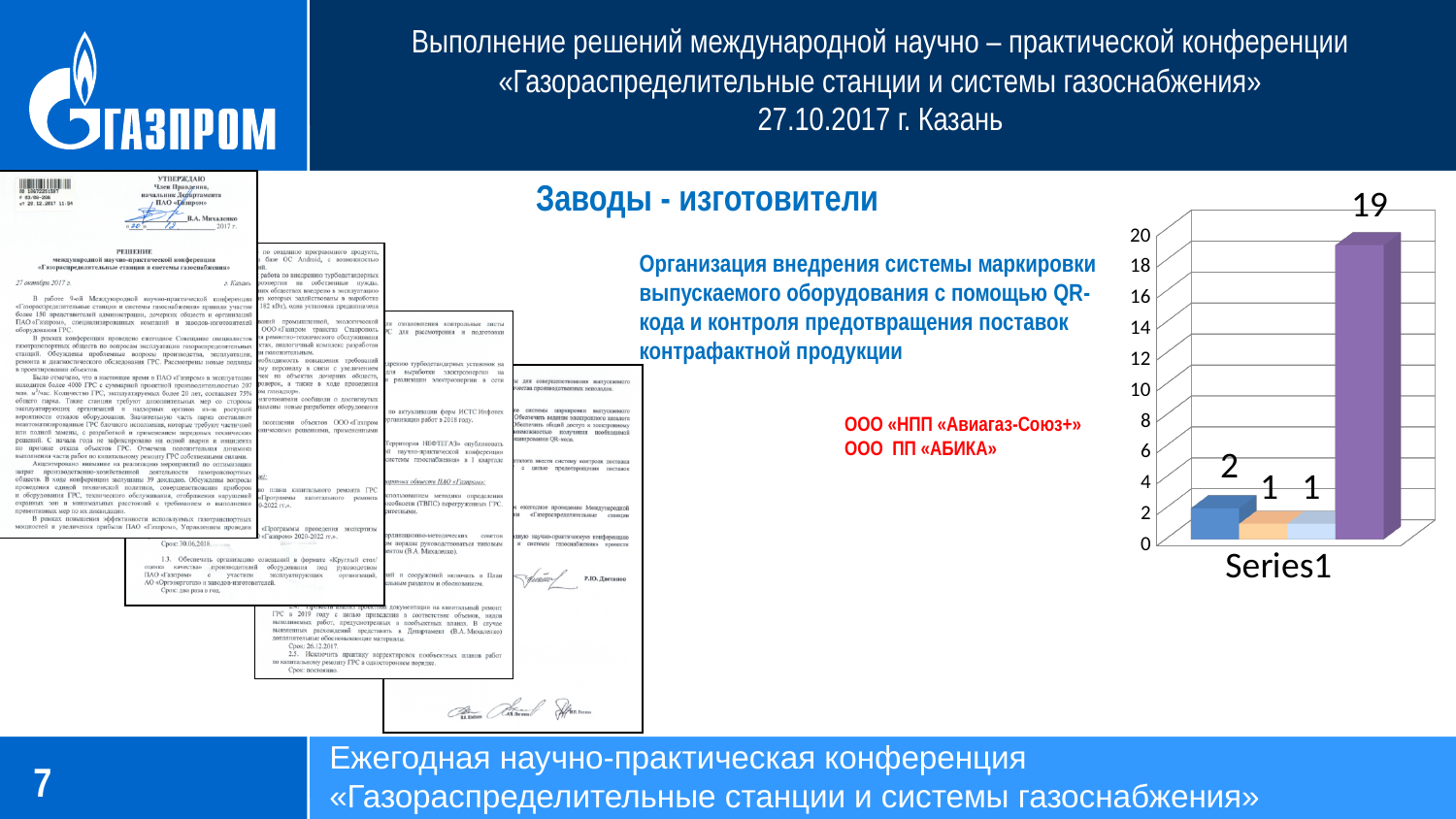
How many bars are plotted in the chart? 4 What label appears below the bars on the x axis of the chart? Series1 What is the value shown on the tallest bar in the chart? 19 Which is larger: the value of the first bar or the value of the fourth bar? the fourth bar What is the value of the second bar in the chart? 1 What is the lowest value shown on any bar in the chart? 1 What is the value of the first (leftmost) bar in the chart? 2 What is the difference between the tallest bar (19) and the leftmost bar (2)? 17 What is the value of the fourth (rightmost) bar in the chart? 19 What kind of chart is shown on the right side of the slide? bar chart What is the sum of all four bar values in the chart? 23 Is the value of the rightmost bar greater or less than 10? greater